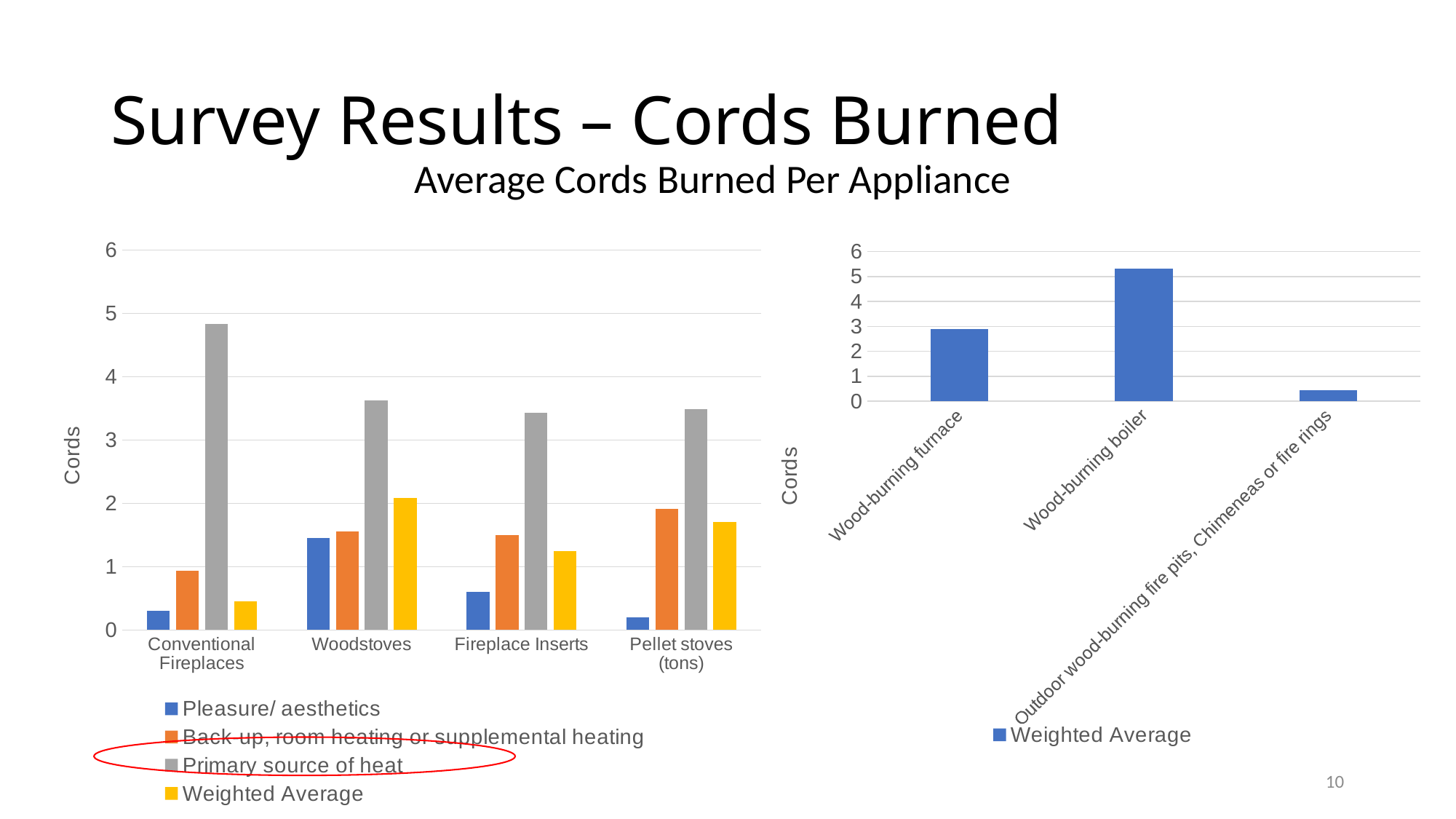
How many appliance categories are shown on the x axis of the left chart? 4 In the left chart, is the Primary source of heat value for Conventional Fireplaces greater or less than 4? greater In the right chart, which category has the lowest Weighted Average? Outdoor wood-burning fire pits, Chimeneas or fire rings In the right chart, which category has the highest Weighted Average? Wood-burning boiler How many series does the legend of the left chart list? 4 In the left chart, which category has the highest value for Primary source of heat? Conventional Fireplaces What kind of chart is the chart on the left of the slide? bar chart In the right chart, is the value for Wood-burning boiler greater or less than 5? greater In the left chart, which is larger for Pleasure/ aesthetics: Woodstoves or Pellet stoves (tons)? Woodstoves How many categories are shown on the x axis of the right chart? 3 In the right chart, is the value for Wood-burning furnace greater or less than 2? greater In the left chart, which category has the highest Weighted Average? Woodstoves